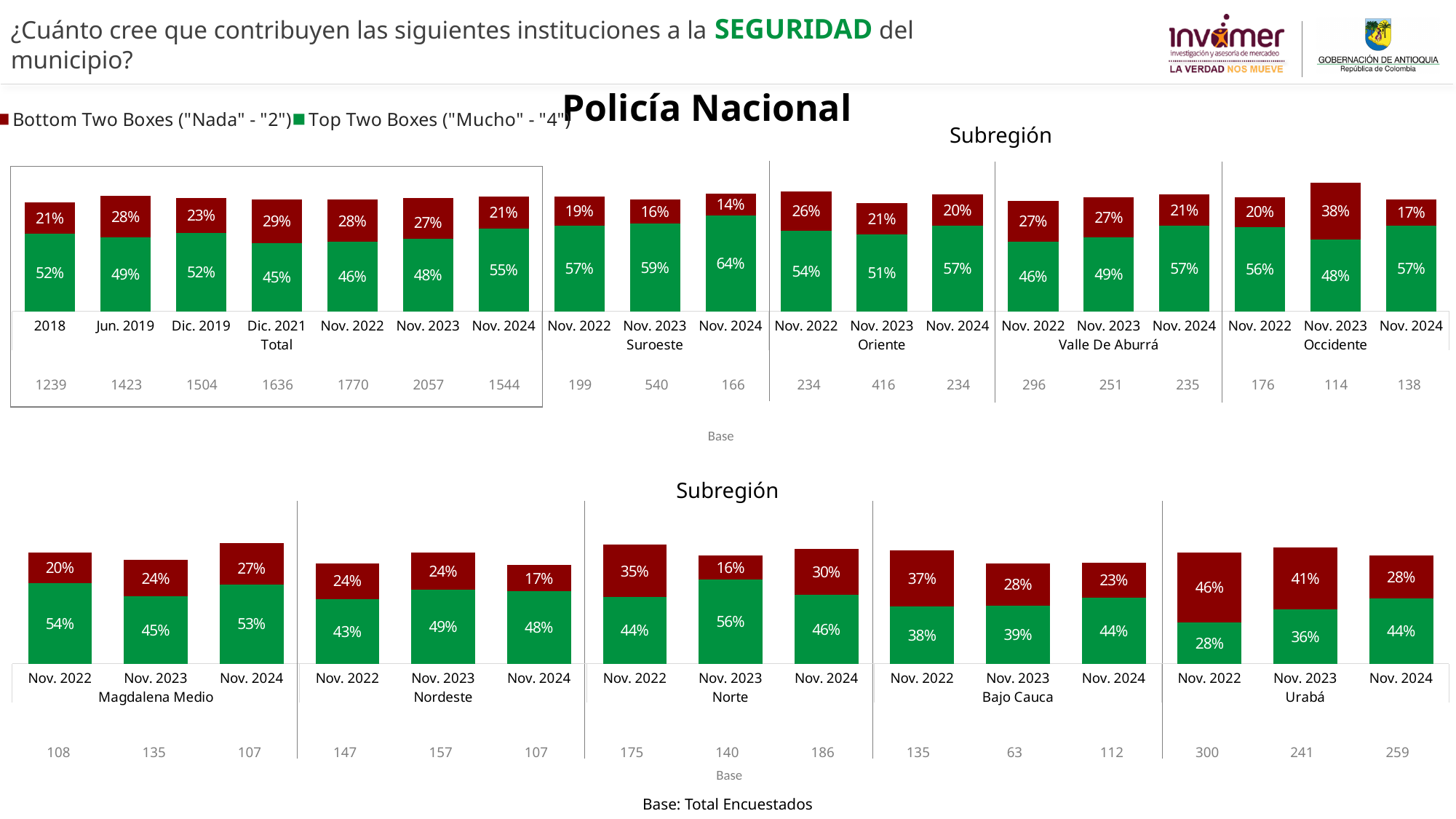
In the top chart, how many Total periods are shown? 7 In the bottom chart, which Nov. 2022 subregion has the lowest Top Two Boxes value? Urabá In the top chart, what is the difference between the Top Two Boxes values for Suroeste in Nov. 2024 and Nov. 2022? 7% In the bottom chart, does the Top Two Boxes value for Urabá rise or fall from Nov. 2022 to Nov. 2024? Rise In the top chart, which Total period has the highest Top Two Boxes value? Nov. 2024 In the top chart, what is the Top Two Boxes value for Total in Nov. 2024? 55% How many series does the legend list? 2 What kind of chart is used on this slide? Stacked bar chart In the bottom chart, what is the Top Two Boxes value for Urabá in Nov. 2022? 28% In the bottom chart, what is the total of the Bottom Two Boxes and Top Two Boxes values for Bajo Cauca in Nov. 2022? 75% In the bottom chart, which is larger for Norte: the Top Two Boxes value in Nov. 2023 or in Nov. 2024? Nov. 2023 In the top chart, what is the Bottom Two Boxes value for Occidente in Nov. 2023? 38%